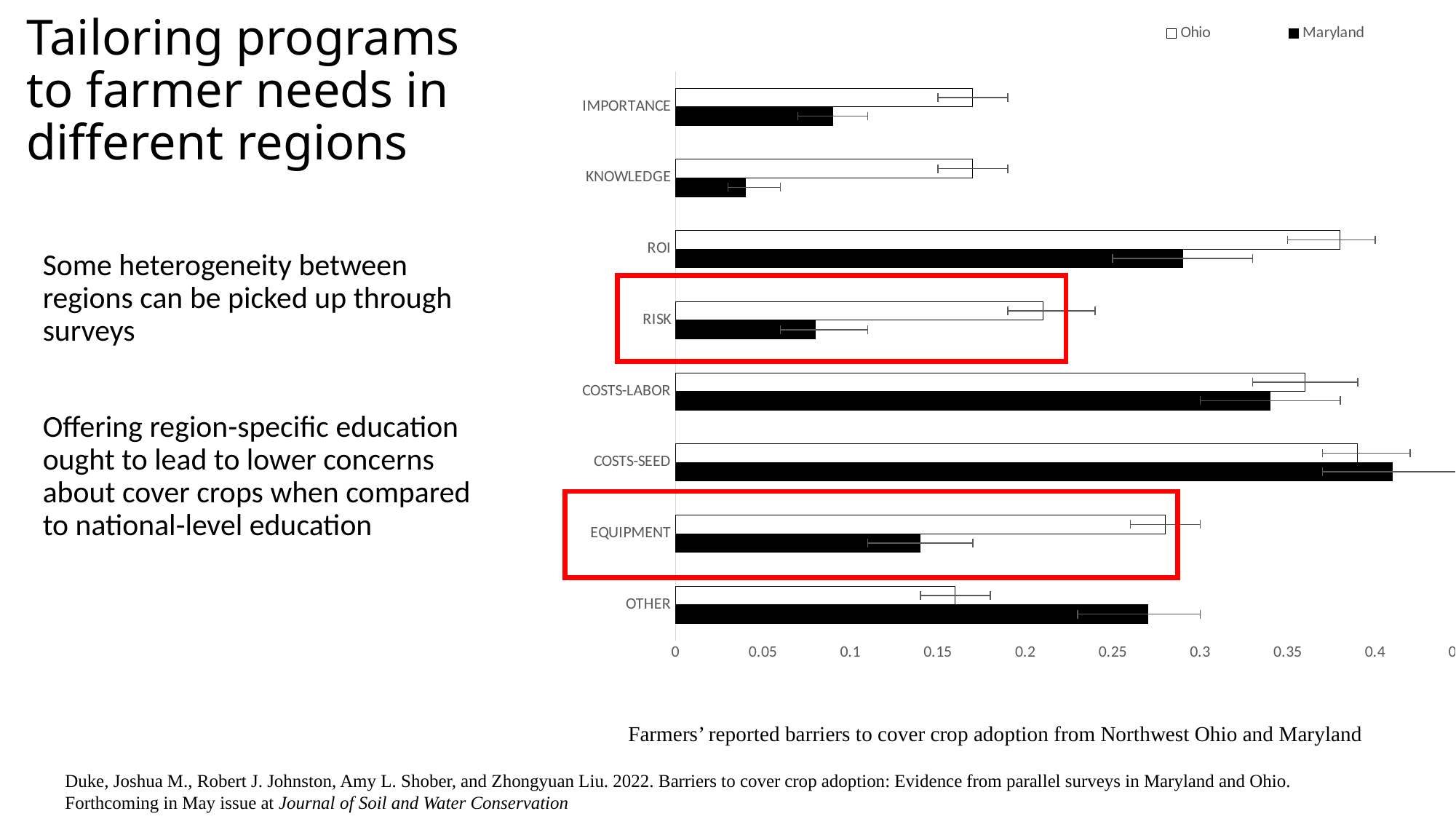
Which two regions are named in the chart's legend? Ohio and Maryland How many series does the chart's legend list? 2 For OTHER, which region has the larger value, Ohio or Maryland? Maryland What kind of chart is shown on the slide? bar chart Is the Ohio value for ROI greater or less than 0.35? greater Is the Maryland value for KNOWLEDGE greater or less than 0.05? less Is the Maryland value for EQUIPMENT greater or less than 0.2? less How many barrier categories are plotted on the chart? 8 For EQUIPMENT, which region has the larger value, Ohio or Maryland? Ohio For RISK, which region has the larger value, Ohio or Maryland? Ohio Which category has the highest value for Maryland? COSTS-SEED Which category has the lowest value for Maryland? KNOWLEDGE